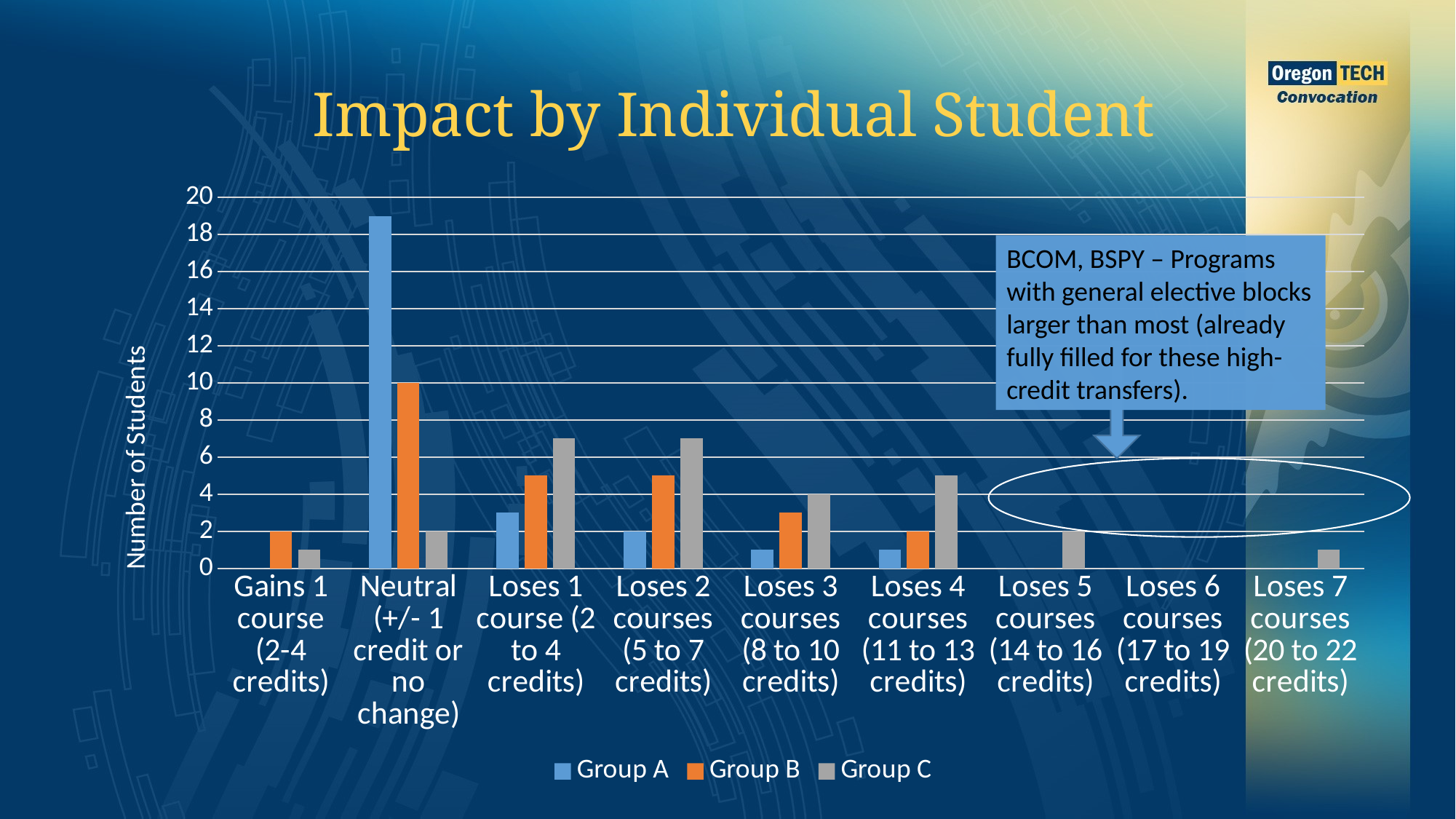
What is the value for Group C in the Loses 3 courses (8 to 10 credits) category? 4 What type of chart is shown on the slide? Bar chart How many series does the legend list? 3 What is the value for Group B in the Neutral (+/- 1 credit or no change) category? 10 How many categories are shown along the x axis? 9 What is the title of the chart? Impact by Individual Student What is the difference between Group B's value in the Neutral category and Group B's value in the Gains 1 course category? 8 In the Loses 1 course (2 to 4 credits) category, which is larger, Group B or Group C? Group C Is the value for Group A in the Neutral (+/- 1 credit or no change) category greater or less than 18? greater Which category has the highest bar for Group A? Neutral (+/- 1 credit or no change) What is the value for Group B in the Gains 1 course (2-4 credits) category? 2 Is the value for Group C in the Loses 1 course (2 to 4 credits) category greater or less than 6? greater